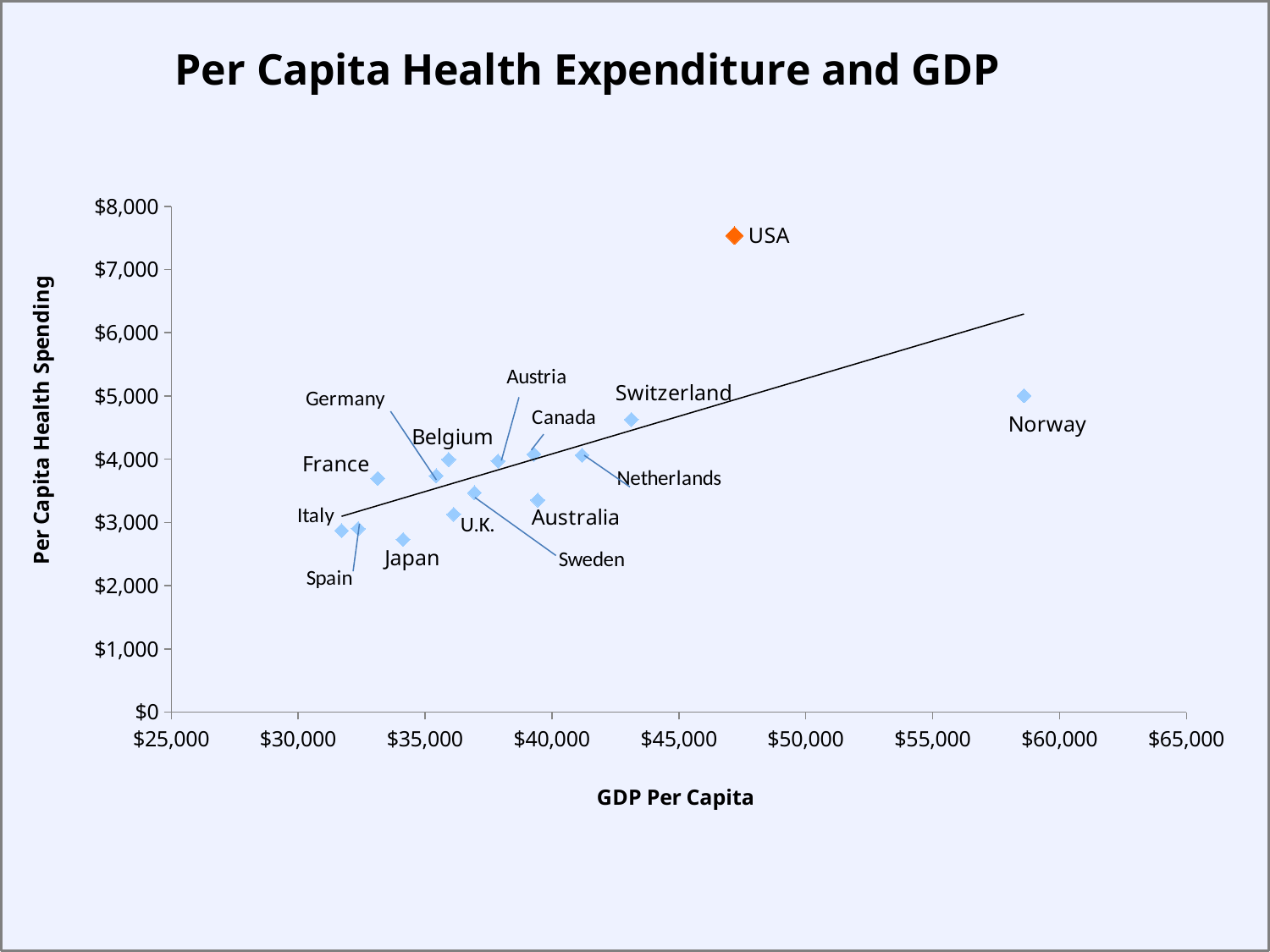
Is the per capita health spending for Japan greater or less than $3,000? less How many countries are plotted on the chart? 15 Which country has the highest GDP per capita? Norway What kind of chart is shown on the slide? scatter chart Is the GDP per capita for Italy greater or less than $35,000? less Is the per capita health spending for Switzerland greater or less than $4,000? greater Which has higher per capita health spending, the USA or Norway? USA Which has higher GDP per capita, Norway or Switzerland? Norway Does the trend line show per capita health spending rising or falling as GDP per capita increases? rising Which country has the highest per capita health spending? USA